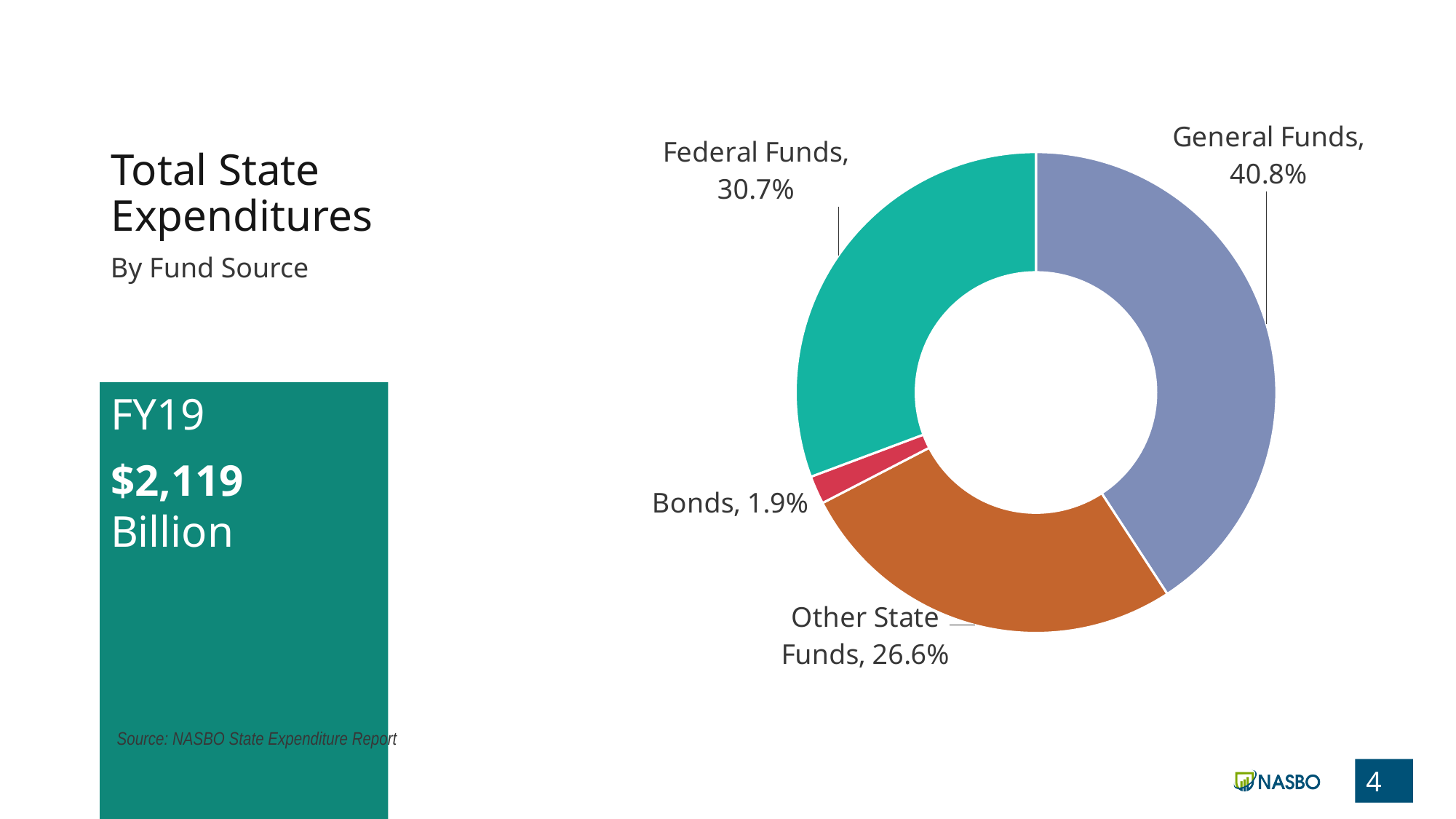
Which fund source has the smallest share of total state expenditures? Bonds What share of total state expenditures comes from Federal Funds? 30.7% What total state expenditure amount for FY19 is shown on the slide? $2,119 Billion Which is larger, the share for Federal Funds or the share for Other State Funds? Federal Funds What share of total state expenditures comes from General Funds? 40.8% How many fund sources are shown in the chart? 4 What kind of chart is shown on the slide? Pie chart (doughnut) What is the difference in percentage points between the General Funds share and the Federal Funds share? 10.1 What share of total state expenditures comes from Other State Funds? 26.6% What is the difference in percentage points between the Federal Funds share and the Other State Funds share? 4.1 What share of total state expenditures comes from Bonds? 1.9% Which fund source has the largest share of total state expenditures? General Funds